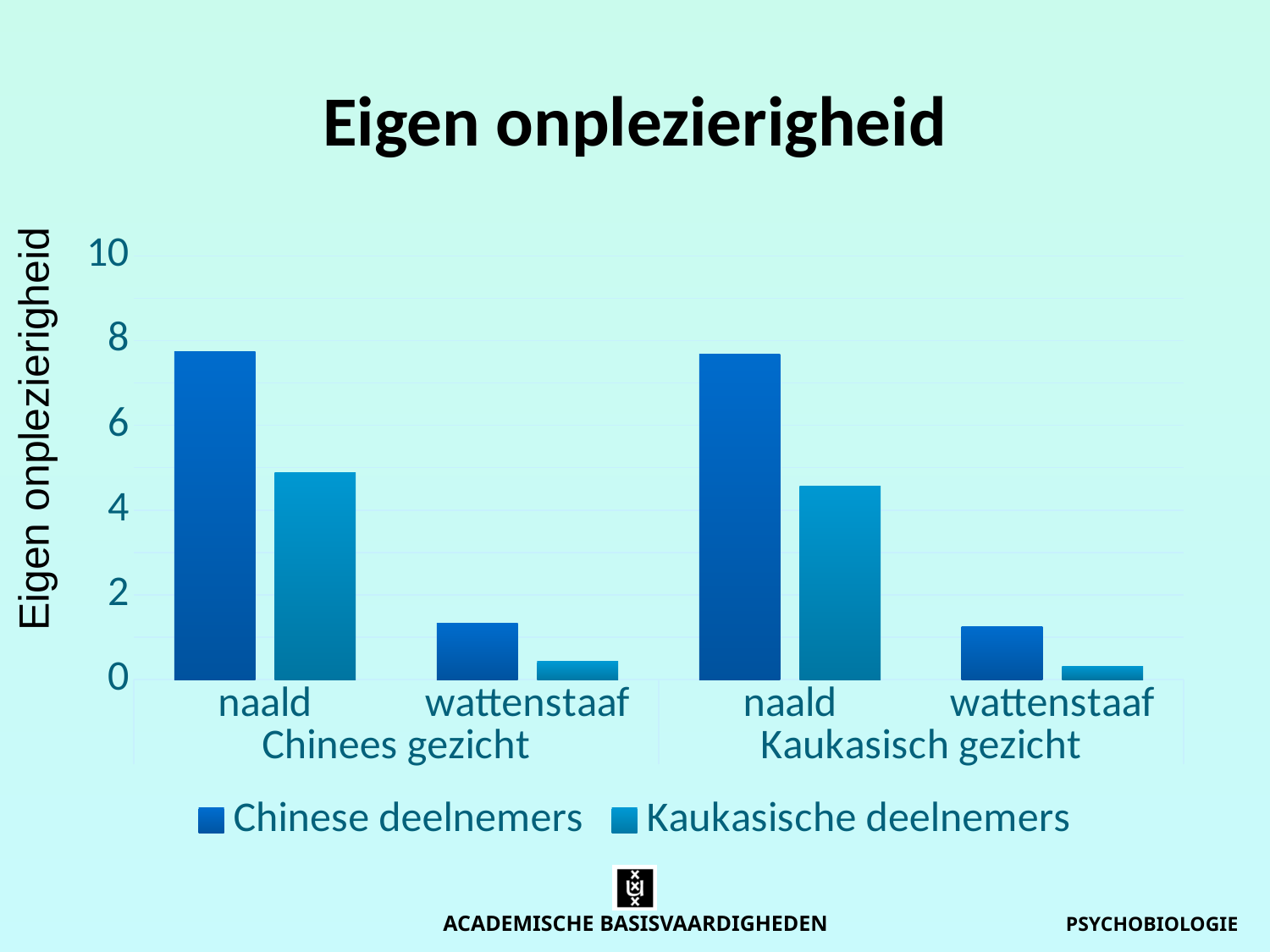
Is the value for Chinese deelnemers for naald under Chinees gezicht greater or less than 6? greater What are the two entries in the legend? Chinese deelnemers and Kaukasische deelnemers How many groups of bars (stimulus conditions) are shown along the x axis? 4 Is the value for Kaukasische deelnemers for naald under Chinees gezicht greater or less than 6? less How many series does the legend list? 2 For naald under Chinees gezicht, which series has the larger value: Chinese deelnemers or Kaukasische deelnemers? Chinese deelnemers What is the title of the chart? Eigen onplezierigheid Is the value for Chinese deelnemers for wattenstaaf under Chinees gezicht greater or less than 2? less Within the Kaukasisch gezicht group, which bar is the highest? Chinese deelnemers, naald For Kaukasische deelnemers under Kaukasisch gezicht, which is larger: naald or wattenstaaf? naald What kind of chart is shown on the slide? bar chart